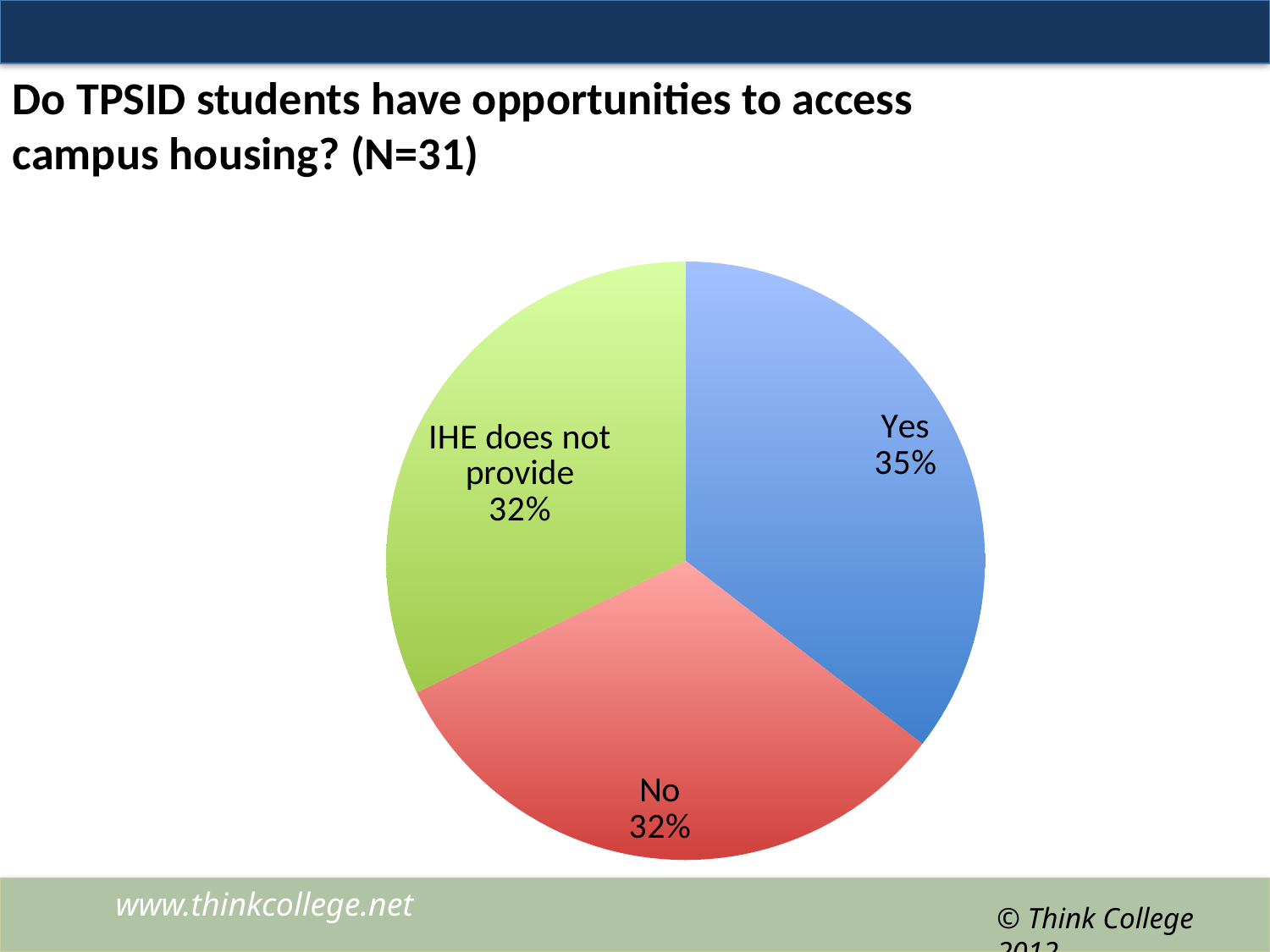
What is the sample size (N) stated in the slide title? 31 What percentage of the pie is labelled "Yes"? 35% What percentage of the pie is labelled "No"? 32% Is the "Yes" slice larger or smaller than the "IHE does not provide" slice? larger What is the difference in percentage points between the "Yes" slice and the "No" slice? 3 What kind of chart is shown on the slide? pie chart How many slices does the pie chart have? 3 What percentage of the pie is labelled "IHE does not provide"? 32% What colour is the "No" slice of the pie? red Which slice of the pie is the largest? Yes